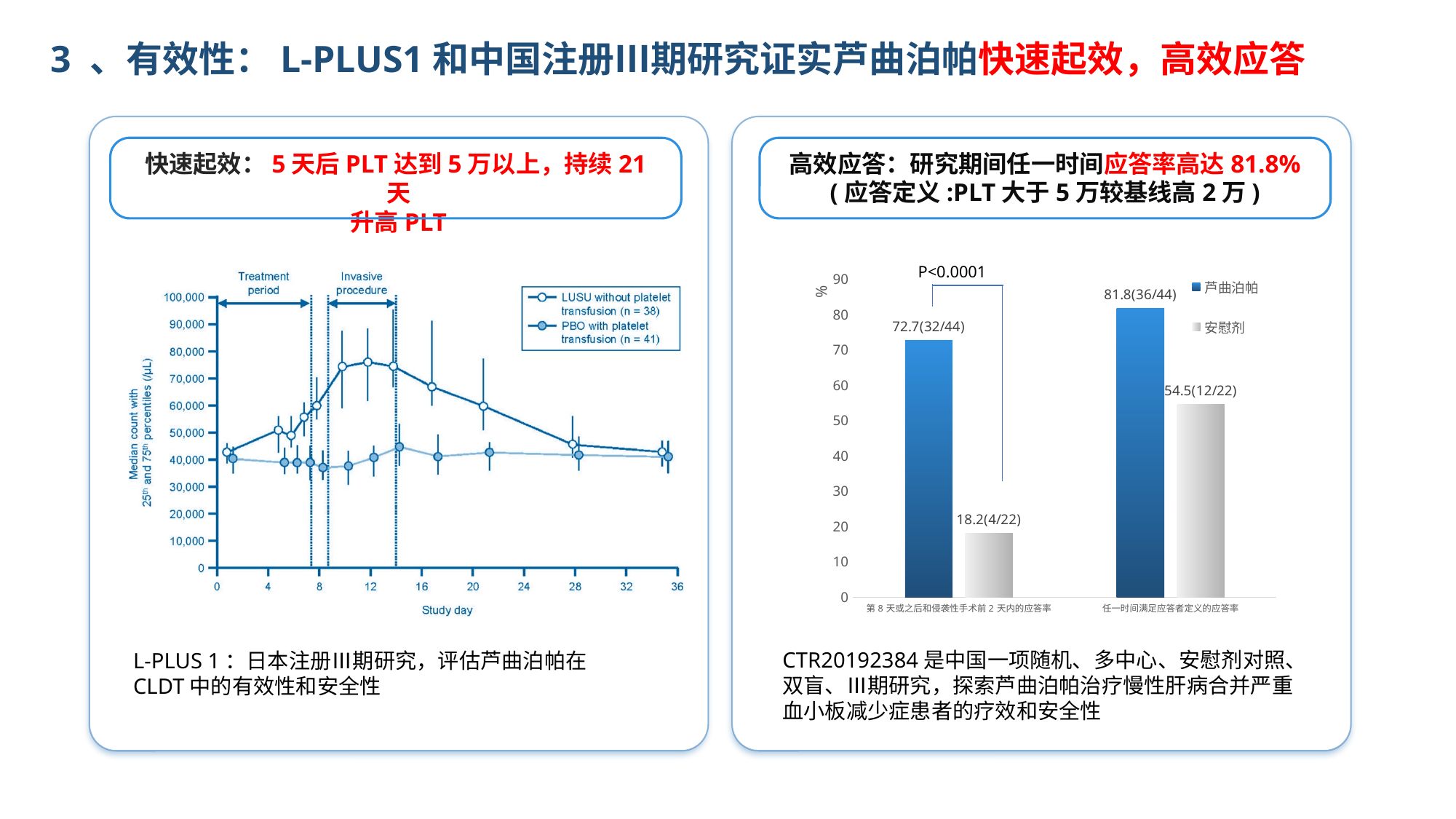
On the right-hand bar chart, what is the value for 安慰剂 in the category 第8天或之后和侵袭性手术前2天内的应答率? 18.2(4/22) On the right-hand bar chart, what p-value is shown above the first pair of bars? P<0.0001 On the left-hand line chart, is the value for LUSU without platelet transfusion at study day 12 greater or less than 70,000? greater What kind of chart is shown on the left-hand side of the slide? Line chart On the right-hand bar chart, what is the value for 芦曲泊帕 in the category 第8天或之后和侵袭性手术前2天内的应答率? 72.7(32/44) On the right-hand bar chart, which bar is the lowest? 安慰剂 in 第8天或之后和侵袭性手术前2天内的应答率 (18.2) On the left-hand line chart, how many series does the legend list? 2 On the right-hand bar chart, what is the value for 安慰剂 in the category 任一时间满足应答者定义的应答率? 54.5(12/22) On the right-hand bar chart, how many series does the legend list? 2 On the right-hand bar chart, what is the value for 芦曲泊帕 in the category 任一时间满足应答者定义的应答率? 81.8(36/44) On the right-hand bar chart, what is the difference in percentage points between 芦曲泊帕 and 安慰剂 in the category 第8天或之后和侵袭性手术前2天内的应答率? 54.5 On the right-hand bar chart, which is larger in the category 任一时间满足应答者定义的应答率: 芦曲泊帕 or 安慰剂? 芦曲泊帕